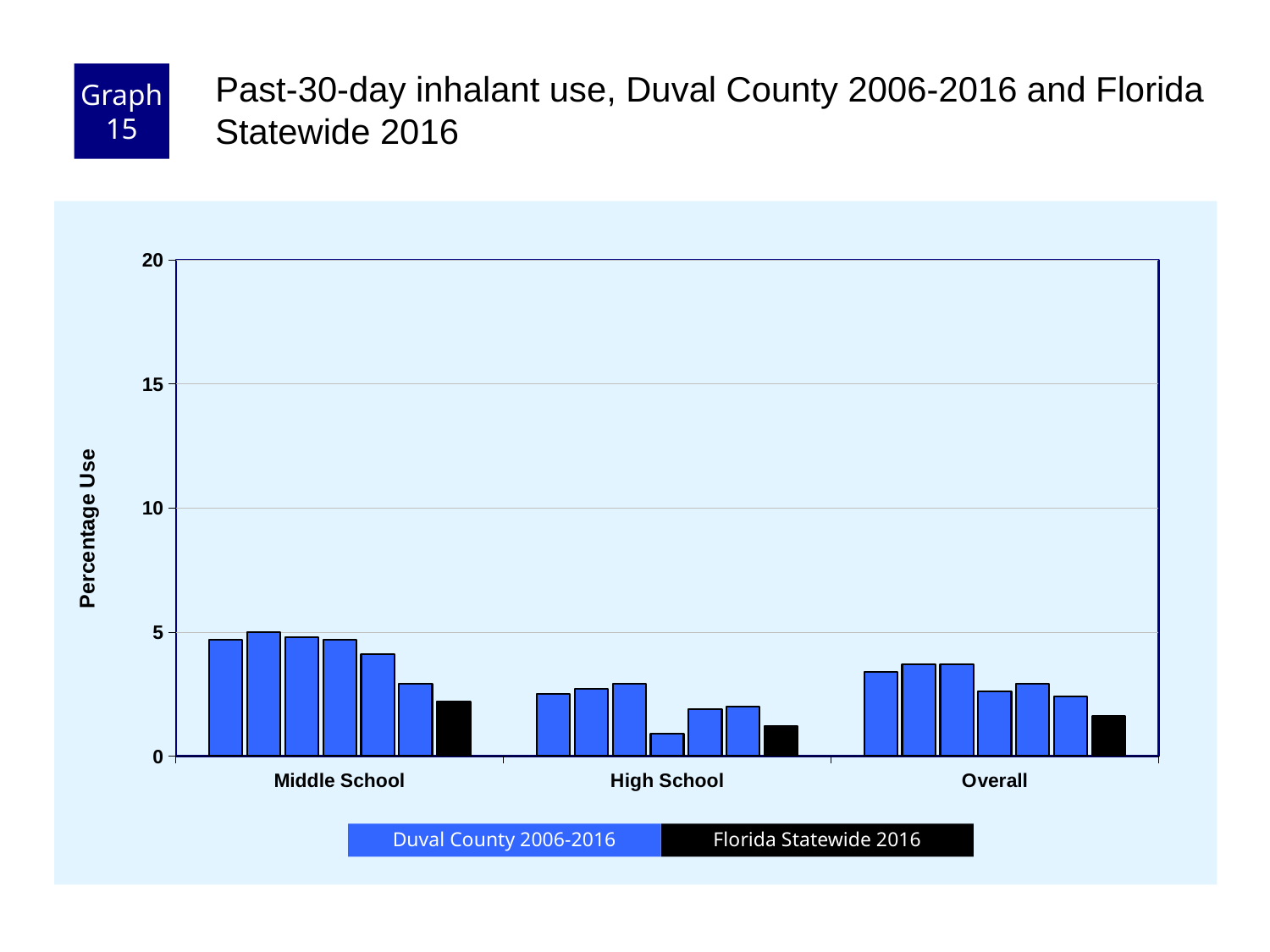
Which category has the lowest Florida Statewide 2016 value? High School How many categories are shown along the x axis? 3 Are all the bars for Overall greater or less than 5? less How many series does the legend list? 2 What is the label on the y axis? Percentage Use Is the Florida Statewide 2016 value for High School greater or less than 5? less Which is larger, the Florida Statewide 2016 value for Overall or for High School? Overall Is the Florida Statewide 2016 value for Middle School greater or less than 5? less What kind of chart is shown on the slide? bar chart Which category has the highest Florida Statewide 2016 value? Middle School Which is larger, the Florida Statewide 2016 value for Middle School or for High School? Middle School What is the title of the chart? Past-30-day inhalant use, Duval County 2006-2016 and Florida Statewide 2016